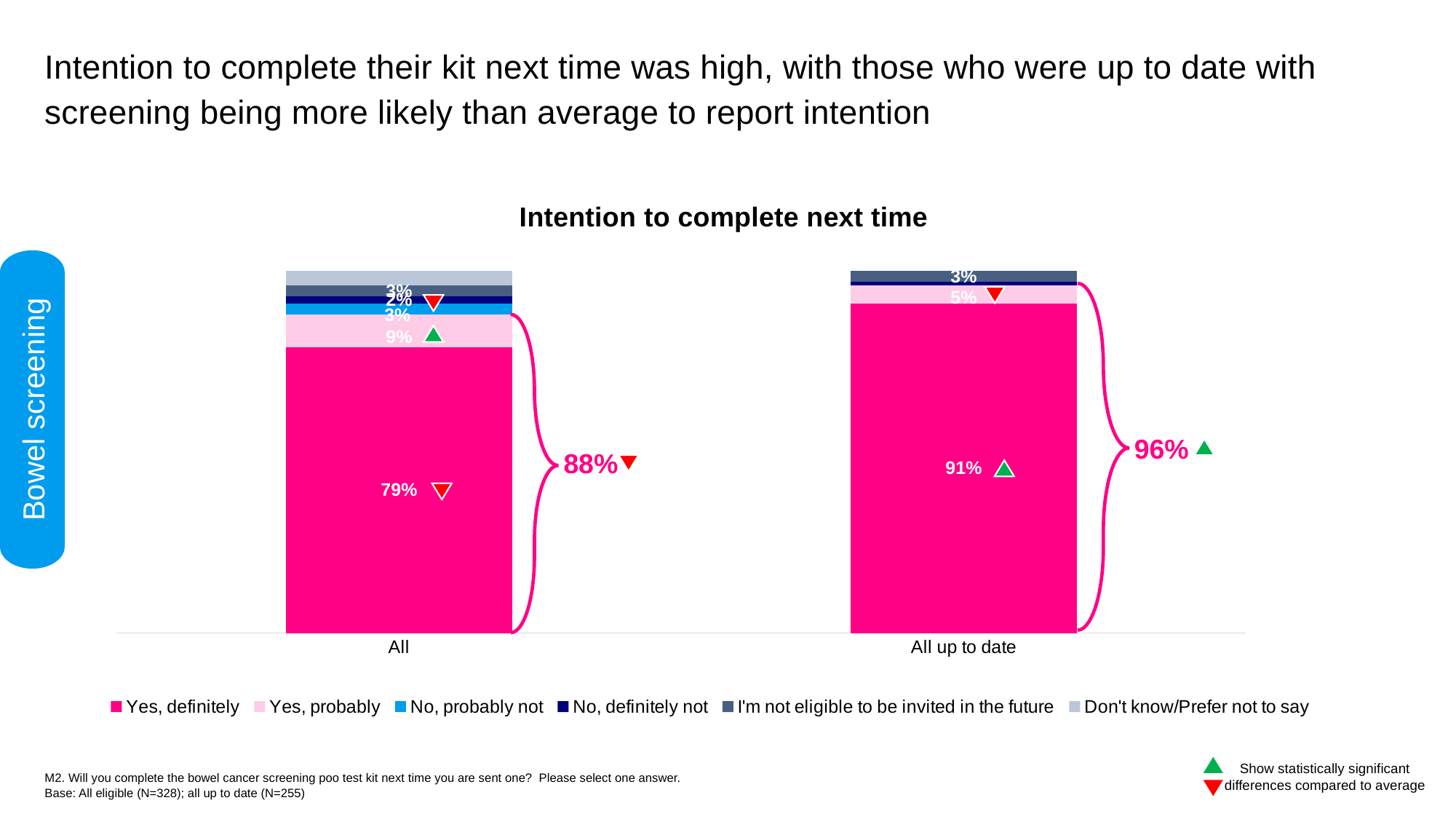
What is the difference in the 'Yes, definitely' value between 'All up to date' and 'All'? 12 percentage points How many series does the chart legend list? 6 What is the title of the chart? Intention to complete next time What is the 'Yes, definitely' value for the 'All up to date' bar? 91% Which category has the larger 'Yes, definitely' value, 'All' or 'All up to date'? All up to date What is the 'Yes, probably' value for the 'All' bar? 9% How many categories are shown on the x axis of the chart? 2 What is the 'Yes, probably' value for the 'All up to date' bar? 5% What combined intention percentage is shown by the brace next to the 'All' bar? 88% What combined intention percentage is shown by the brace next to the 'All up to date' bar? 96% What is the 'Yes, definitely' value for the 'All' bar? 79% What kind of chart is shown on the slide? Stacked bar chart